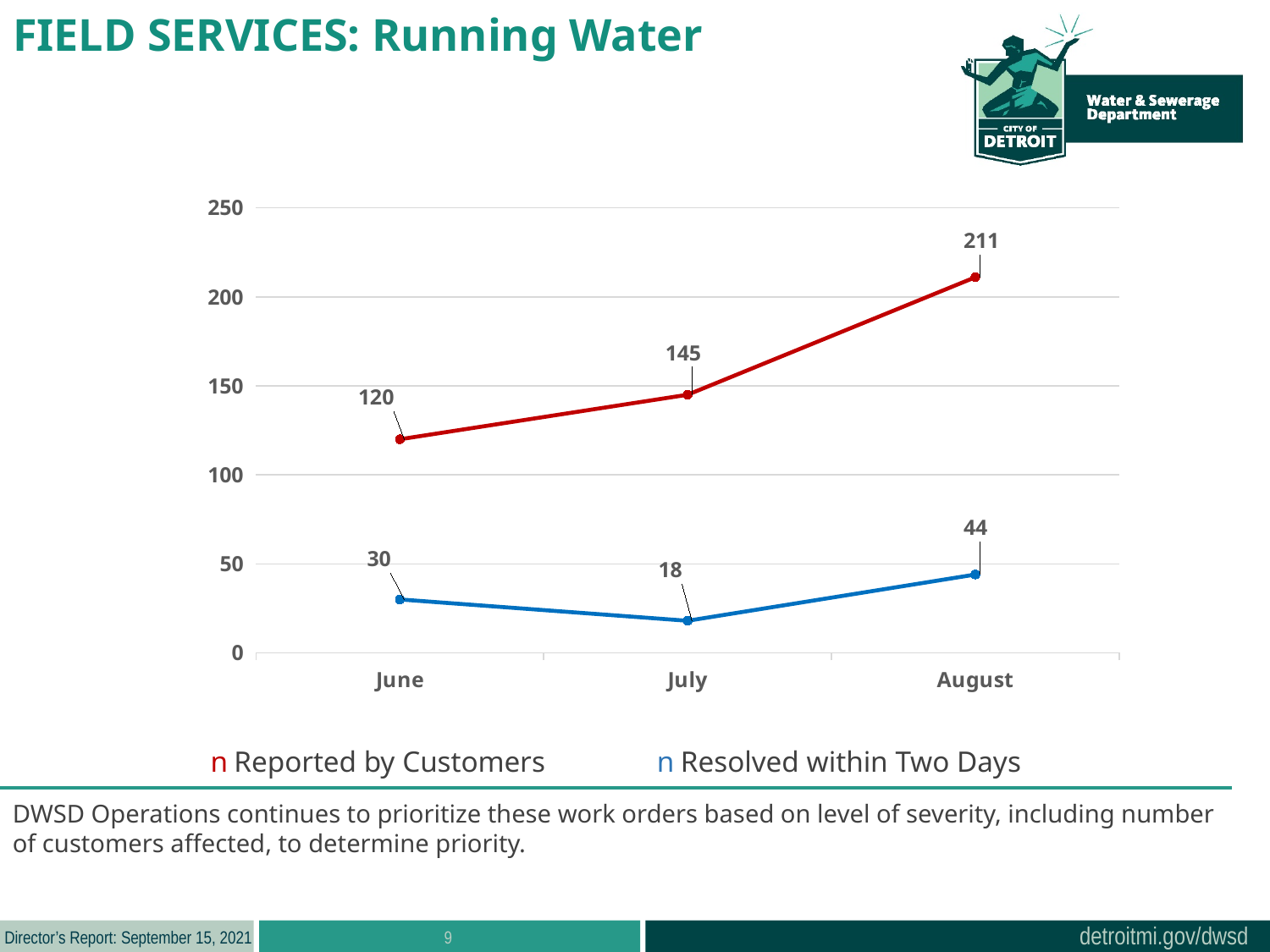
In which month is Resolved within Two Days lowest? July Is the value for Reported by Customers in July greater or less than 100? greater What is the difference between Reported by Customers and Resolved within Two Days in August? 167 In which month is Reported by Customers highest? August What is the value for Reported by Customers in August? 211 What is the value for Reported by Customers in June? 120 Does the Reported by Customers series rise or fall from June to August? rise What is the value for Resolved within Two Days in July? 18 What kind of chart is shown on the slide? line chart How many series does the legend list? 2 How many months are shown on the x axis? 3 Which is larger: Resolved within Two Days in June or in August? August